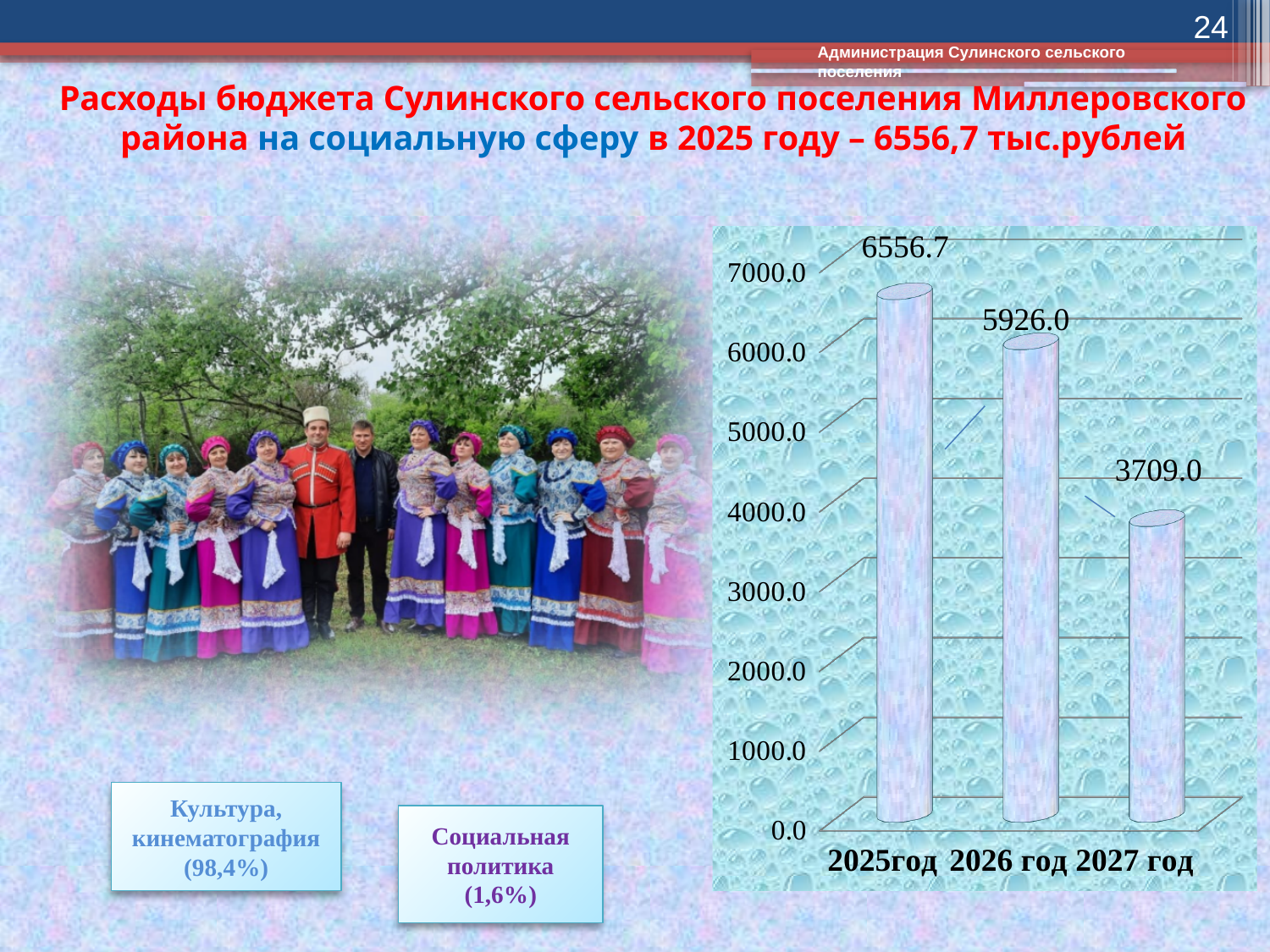
What is the value for 2027 год? 3709.0 What kind of chart is shown on the slide? bar chart Which year has the highest value? 2025год What is the value for 2025год? 6556.7 Do the values rise or fall from 2025год to 2027 год? fall How many categories are shown on the x axis? 3 What is the difference between the values for 2025год and 2026 год? 630.7 What is the value for 2026 год? 5926.0 Is the value for 2027 год greater or less than 4000.0? less Which year has the lowest value? 2027 год Which is larger, the value for 2026 год or the value for 2027 год? 2026 год What is the difference between the values for 2026 год and 2027 год? 2217.0